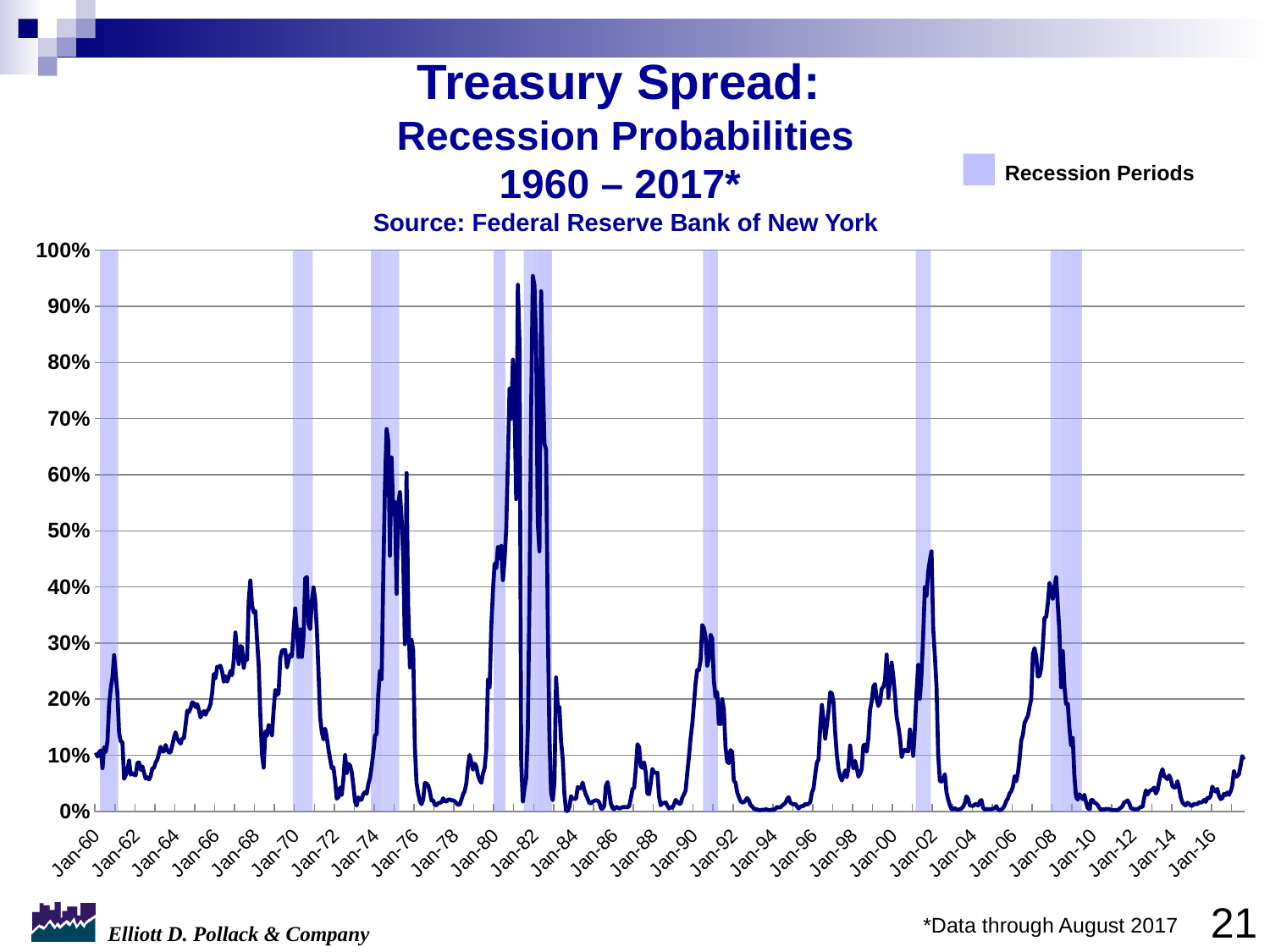
What does the shaded legend entry on the chart represent? Recession Periods What is the title of the chart? Treasury Spread: Recession Probabilities 1960 – 2017* Around which x-axis label does the recession probability reach its highest point? Jan-82 Is the recession probability at Jan-16 greater or less than 10%? less Is the recession probability at Jan-94 greater or less than 10%? less Which peak is higher: the one around Jan-74 or the one around Jan-08? Jan-74 Is the peak recession probability around Jan-08 greater or less than 30%? greater How many shaded recession periods are marked on the chart? 8 Which peak is higher: the one around Jan-90 or the one around Jan-02? Jan-02 What kind of chart is shown on the slide? line chart Does the recession probability generally rise or fall from Jan-62 to Jan-68? rise